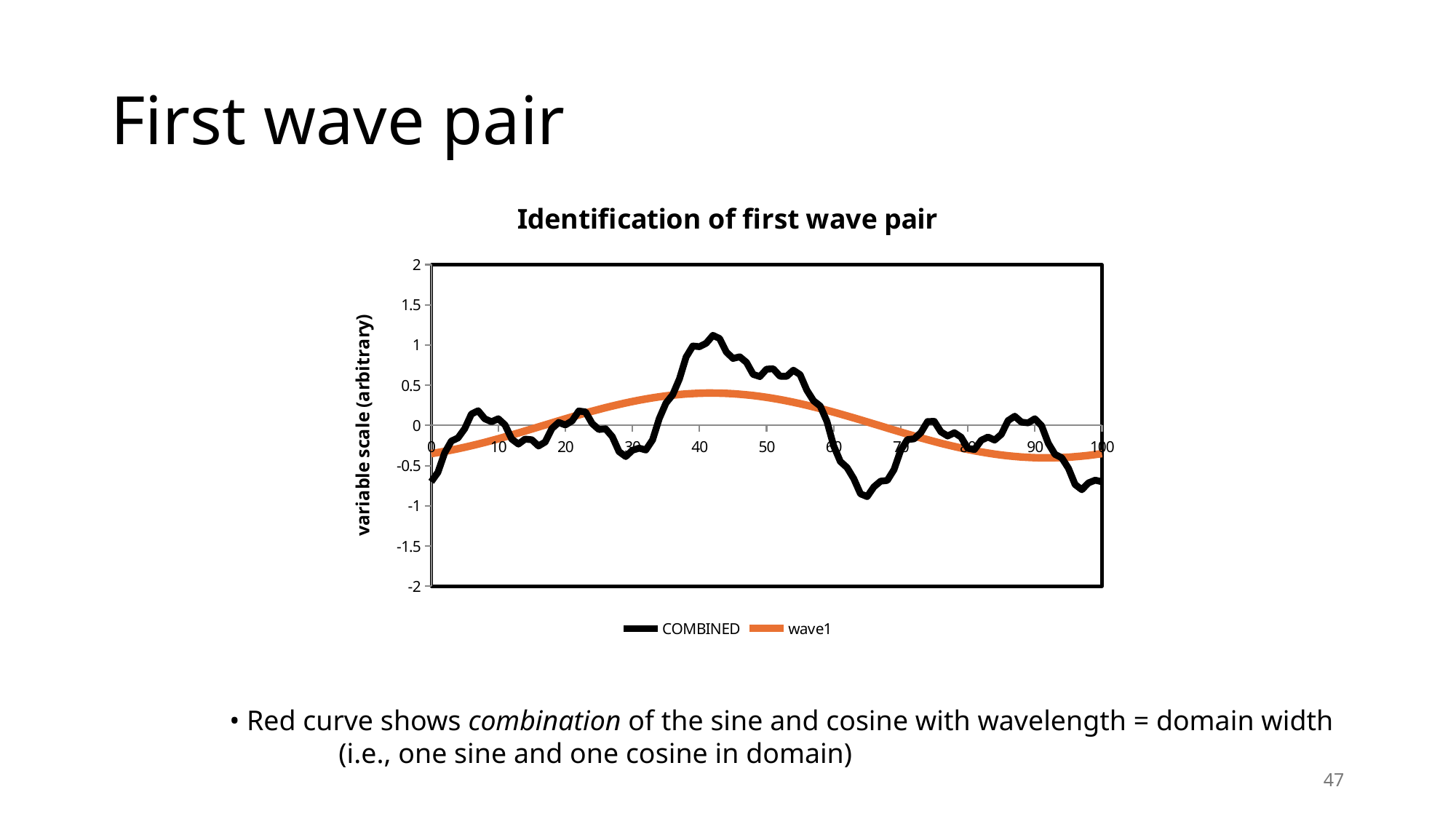
What kind of chart is shown on the slide? line chart How many series does the legend list? 2 Does the wave1 series rise or fall between x = 40 and x = 90? fall Is the value of the COMBINED series at x = 40 greater or less than 0.5? greater Is the value of the wave1 series at x = 0 greater or less than 0? less What is the label on the vertical axis of the chart? variable scale (arbitrary) At x = 40, which series has the higher value, COMBINED or wave1? COMBINED Is the value of the COMBINED series at x = 65 greater or less than -0.5? less At x = 65, which series has the higher value, COMBINED or wave1? wave1 What is the title of the chart? Identification of first wave pair